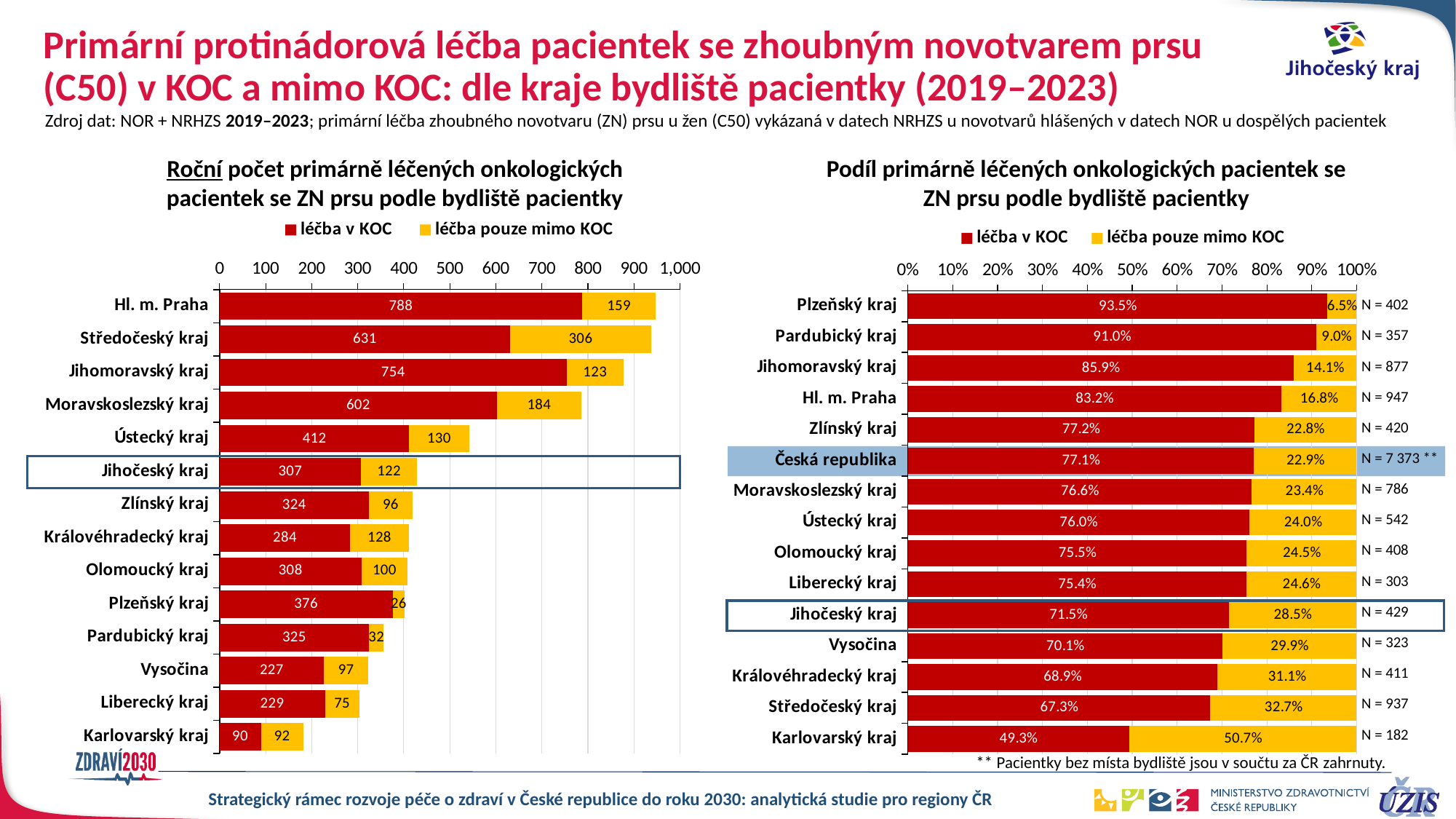
In the left chart (Roční počet primárně léčených onkologických pacientek), which has a larger léčba v KOC value: Ústecký kraj or Plzeňský kraj? Ústecký kraj What type of chart is the left chart (Roční počet primárně léčených onkologických pacientek)? Stacked bar chart In the left chart (Roční počet primárně léčených onkologických pacientek), what is the value of léčba pouze mimo KOC for Středočeský kraj? 306 In the left chart (Roční počet primárně léčených onkologických pacientek), what is the difference between the léčba v KOC values for Hl. m. Praha and Jihomoravský kraj? 34 In the right chart (Podíl primárně léčených onkologických pacientek), how many categories (bars) are shown? 15 In the right chart (Podíl primárně léčených onkologických pacientek), what is the léčba v KOC share for Česká republika? 77.1% In the left chart (Roční počet primárně léčených onkologických pacientek), which region has the highest value for léčba v KOC? Hl. m. Praha In the right chart (Podíl primárně léčených onkologických pacientek), which region has the highest share of léčba pouze mimo KOC? Karlovarský kraj In the left chart (Roční počet primárně léčených onkologických pacientek), which region has the lowest value for léčba v KOC? Karlovarský kraj In the left chart (Roční počet primárně léčených onkologických pacientek), what is the value of léčba v KOC for Jihočeský kraj? 307 In the left chart (Roční počet primárně léčených onkologických pacientek), what is the total of the stacked bar for Jihočeský kraj? 429 How many series does the legend of the left chart (Roční počet primárně léčených onkologických pacientek) list? 2